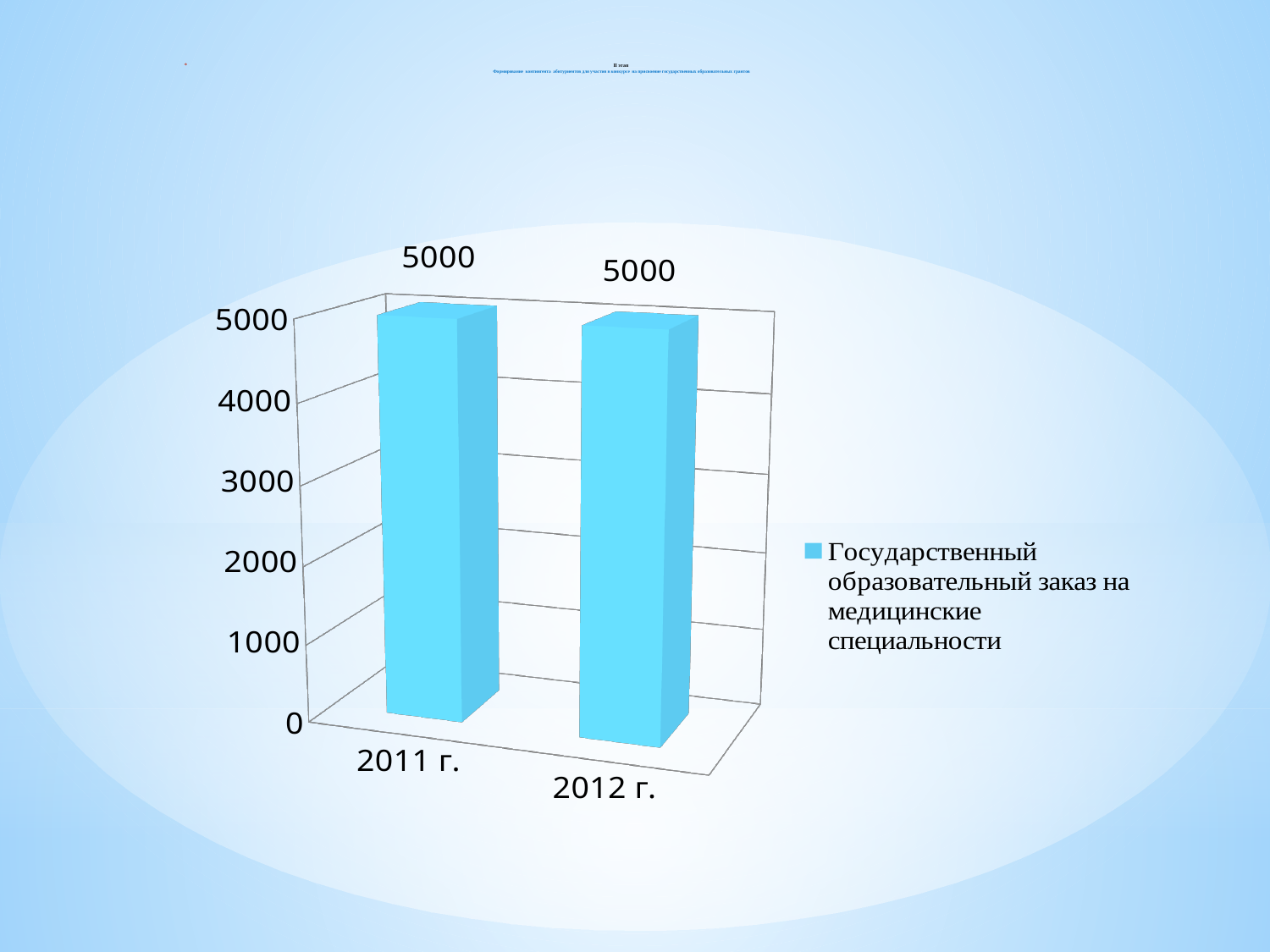
What series name is shown in the legend? Государственный образовательный заказ на медицинские специальности How many series does the legend list? 1 Is the value for 2011 г. greater or less than 1000? greater What is the difference between the values for 2011 г. and 2012 г.? 0 How many categories are shown on the x axis? 2 What colour are the bars in the chart? light blue Do the values rise, fall, or stay the same from 2011 г. to 2012 г.? stay the same Is the value for 2011 г. larger than, smaller than, or equal to the value for 2012 г.? equal What is the value for 2011 г.? 5000 What kind of chart is shown on the slide? bar chart What is the value for 2012 г.? 5000 Is the value for 2012 г. greater or less than 4000? greater